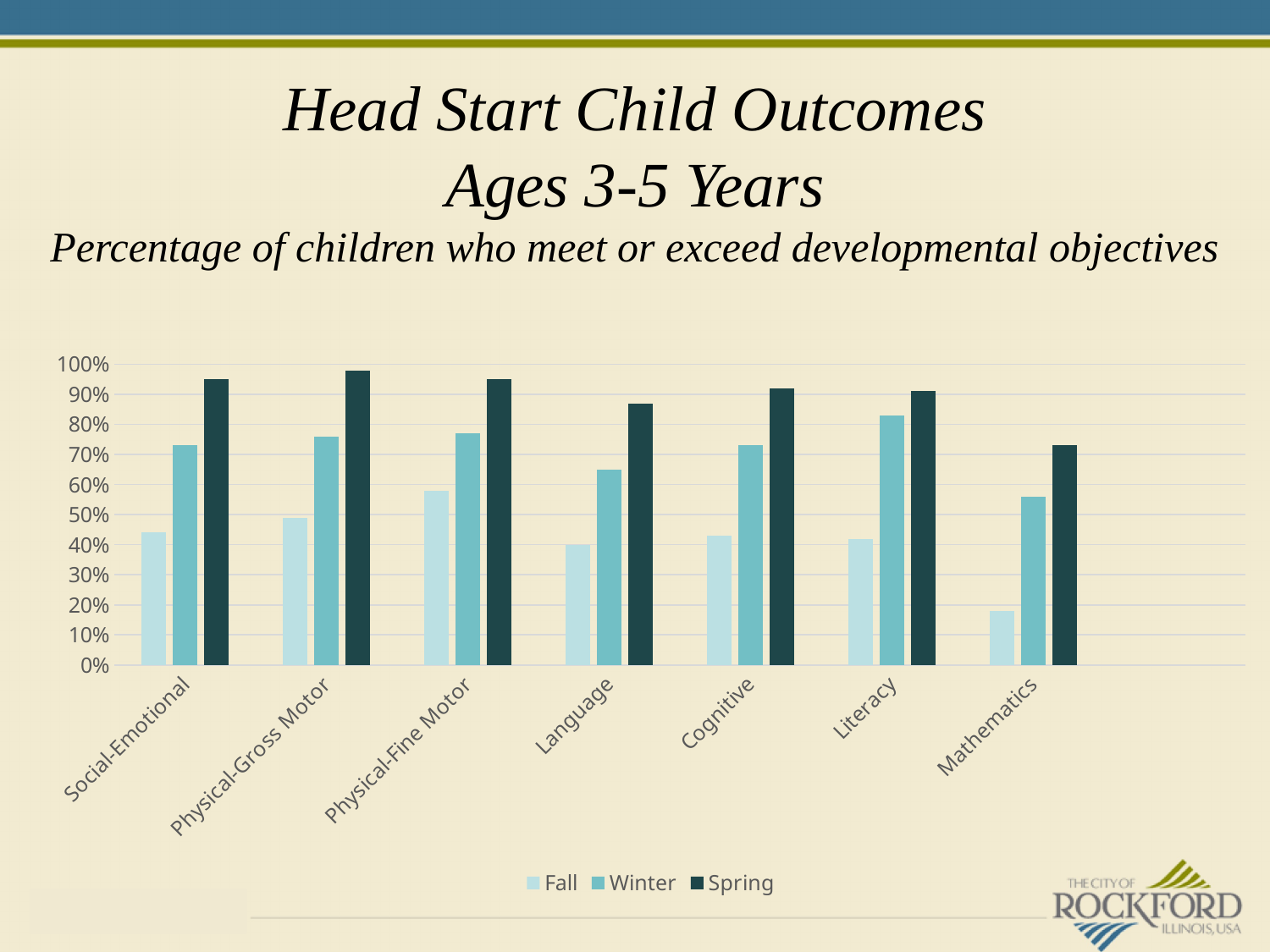
Which series is shown in the darkest colour in the legend? Spring Which category has the lowest Fall value? Mathematics For Literacy, which is larger, the Fall value or the Winter value? Winter Is the Spring value for Language greater or less than 80%? greater What kind of chart is shown on the slide? bar chart Which category has the highest Spring value? Physical-Gross Motor Which category has the lowest Spring value? Mathematics Is the Winter value for Mathematics greater or less than 60%? less Is the Fall value for Mathematics greater or less than 20%? less Which category has the highest Winter value? Literacy How many series does the legend list? 3 How many categories are shown on the x axis? 7